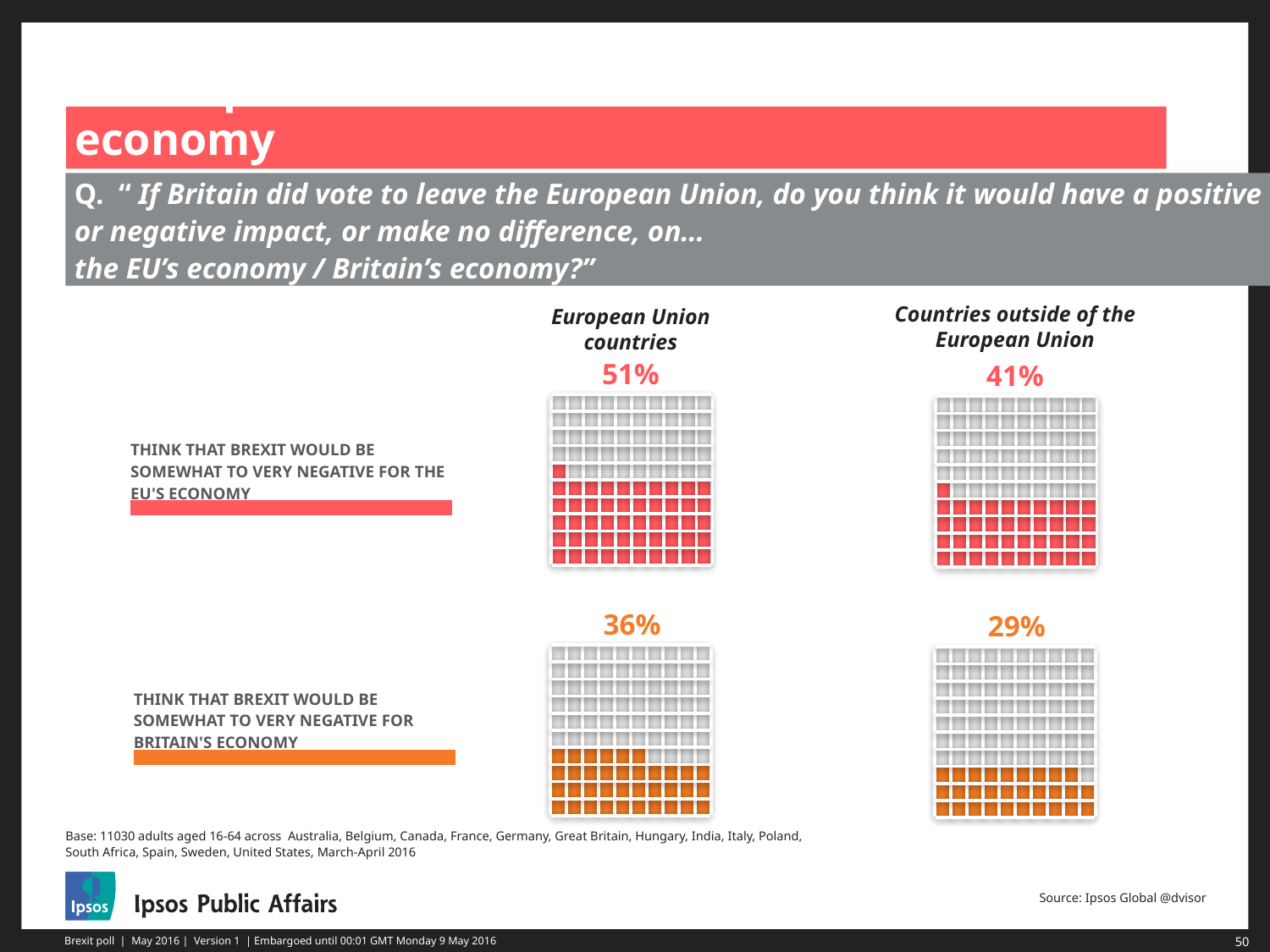
In countries outside of the European Union, is the share thinking Brexit would be negative for the EU's economy greater or less than 50%? less How many respondent groups (columns) are compared in the charts on the slide? 2 What percentage of respondents in European Union countries think Brexit would be somewhat to very negative for the EU's economy? 51% What percentage of respondents in countries outside of the European Union think Brexit would be somewhat to very negative for Britain's economy? 29% What percentage of respondents in European Union countries think Brexit would be somewhat to very negative for Britain's economy? 36% In European Union countries, which is larger: the share thinking Brexit would be negative for the EU's economy or the share thinking it would be negative for Britain's economy? Negative for the EU's economy For the view that Brexit would be negative for Britain's economy, what is the difference in percentage points between European Union countries and countries outside of the European Union? 7 Which of the four percentages shown on the slide is the highest? 51% Which of the four percentages shown on the slide is the lowest? 29% What percentage of respondents in countries outside of the European Union think Brexit would be somewhat to very negative for the EU's economy? 41% For the view that Brexit would be negative for the EU's economy, what is the difference in percentage points between European Union countries and countries outside of the European Union? 10 What colour are the filled squares in the charts about Brexit being negative for Britain's economy? Orange